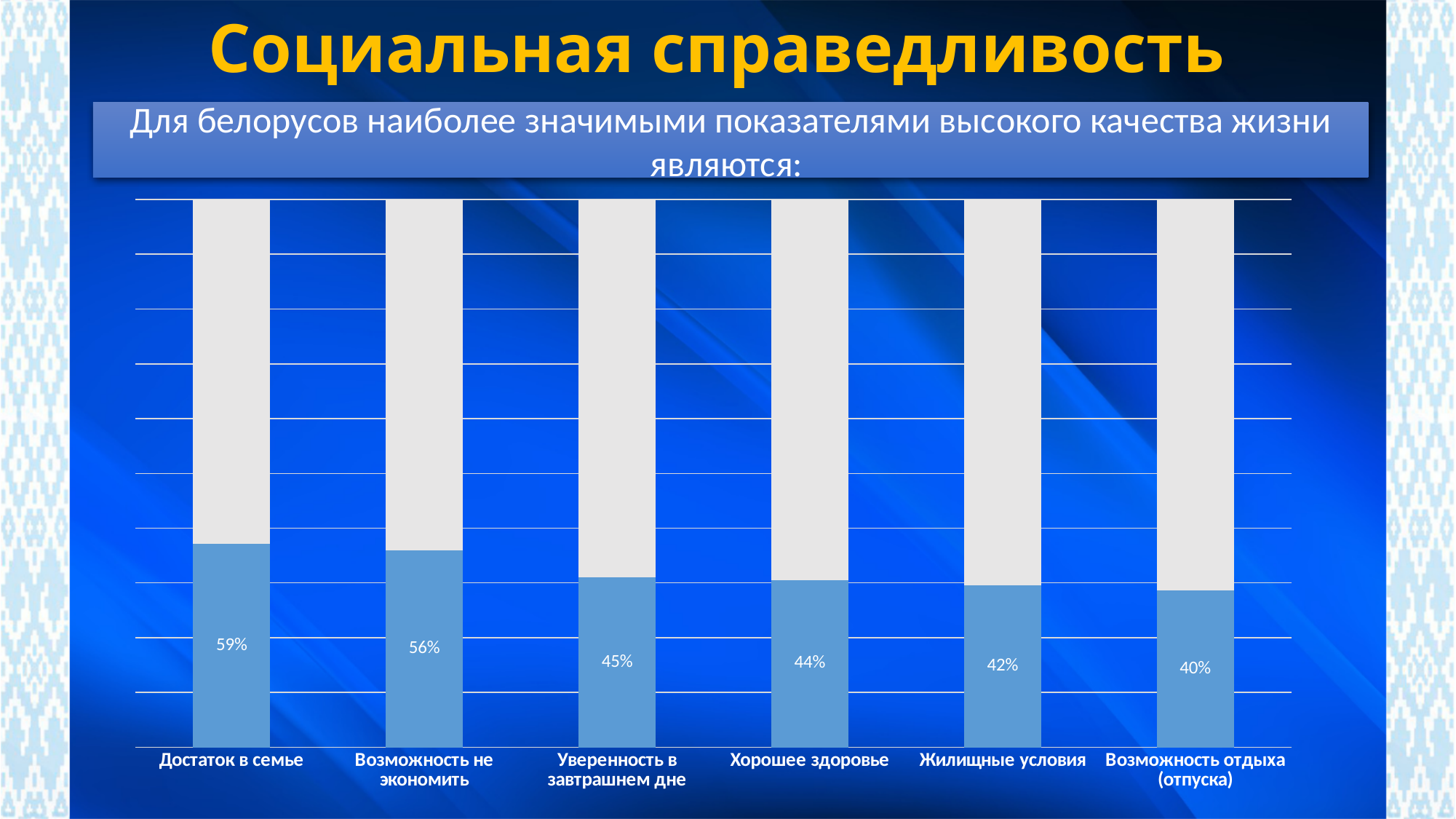
What is the value shown for «Хорошее здоровье»? 44% What is the difference between the values for «Достаток в семье» and «Жилищные условия»? 17% Do the labelled values rise or fall from left to right across the categories? Fall What kind of chart is shown on the slide? Bar chart What is the value shown for «Возможность не экономить»? 56% Which is larger: the value for «Возможность не экономить» or the value for «Хорошее здоровье»? Возможность не экономить How many categories are shown on the chart? 6 Which category has the highest value? Достаток в семье What is the value shown for «Возможность отдыха (отпуска)»? 40% What is the value shown for «Уверенность в завтрашнем дне»? 45% What is the value shown for «Достаток в семье»? 59% Which category has the lowest value? Возможность отдыха (отпуска)